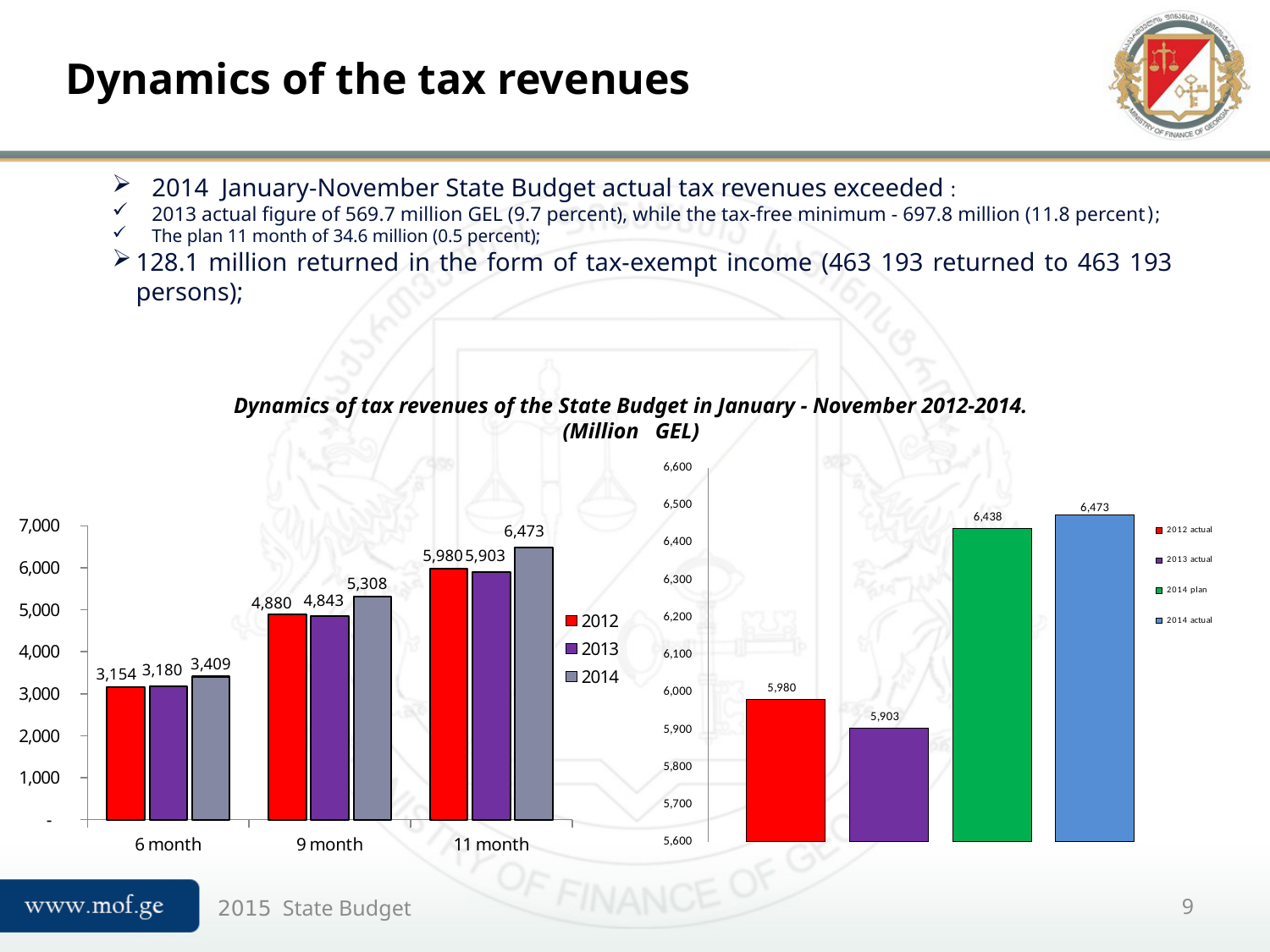
In the left chart, what is the value for 2012 at 6 month? 3,154 In the left chart, how many series does the legend list? 3 In the right chart, what is the value for 2014 plan? 6,438 In the left chart, what is the value for 2014 at 9 month? 5,308 In the left chart, which series has the lowest value at 6 month? 2012 In the left chart, how many categories are shown on the x axis? 3 What kind of chart is the right chart? Bar chart In the right chart, what is the difference between 2014 actual and 2014 plan? 35 In the left chart, what is the difference between the 2014 and 2013 values at 9 month? 465 In the left chart, what is the value for 2013 at 11 month? 5,903 In the right chart, which bar is the lowest? 2013 actual In the left chart, which series has the highest value at 11 month? 2014